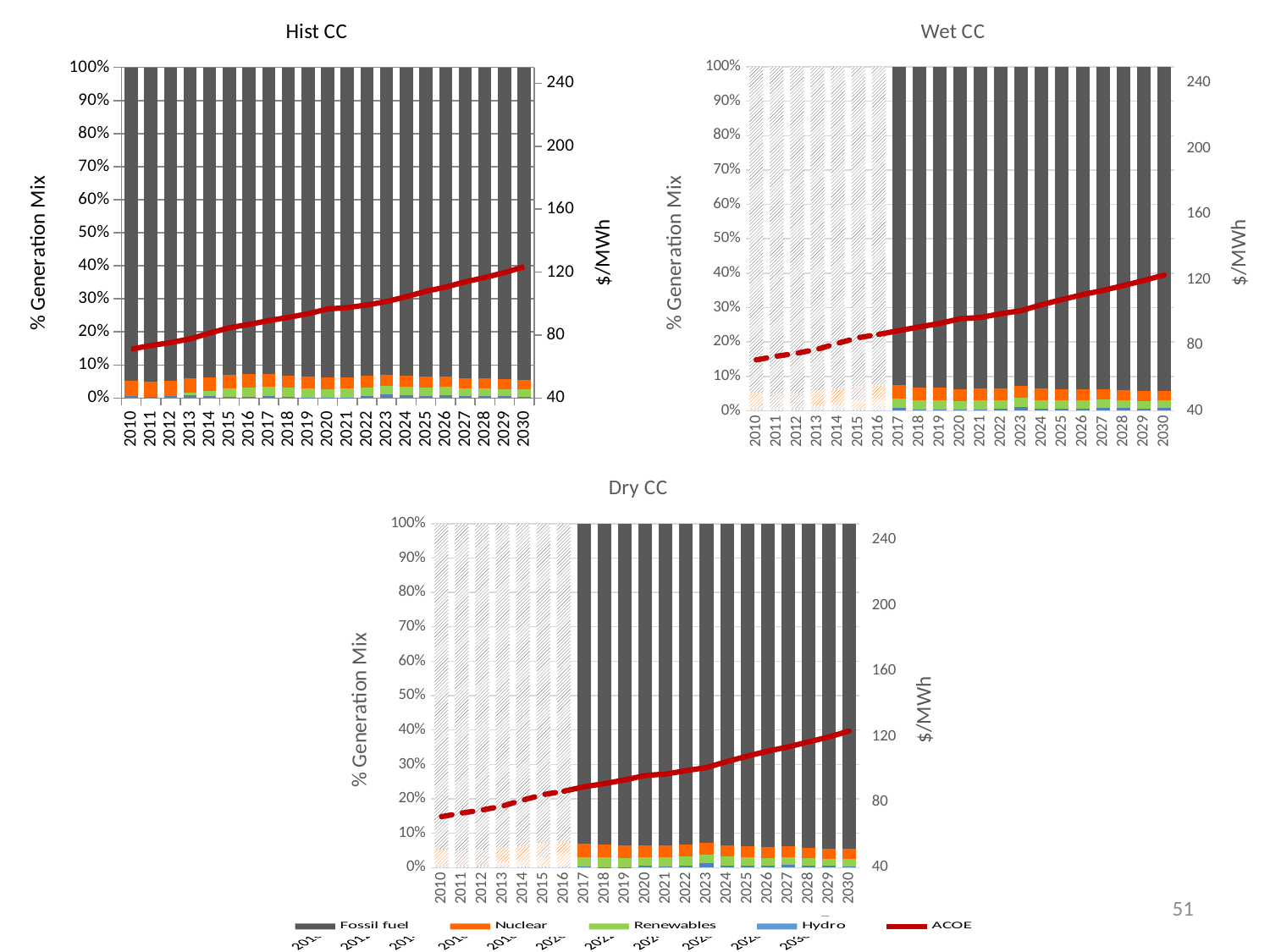
Which series is drawn as a red line in the charts? ACOE What are the titles of the three charts on the slide? Hist CC, Wet CC, Dry CC In the Wet CC chart, is the ACOE value for 2030 greater or less than 100 $/MWh? greater How many series does the legend at the bottom of the slide list? 5 In the Wet CC chart, which is larger in 2020: the Fossil fuel share or the Nuclear share? Fossil fuel How many charts are on the slide? 3 In the Hist CC chart, how many years are shown on the x axis? 21 In the Dry CC chart, is the ACOE value for 2020 greater or less than 120 $/MWh? less In the Hist CC chart, is the ACOE value for 2010 greater or less than 80 $/MWh? less In the Hist CC chart, does the ACOE line rise or fall from 2010 to 2030? Rise In the Dry CC chart, which series makes up the largest share of the generation mix in 2030? Fossil fuel In the Hist CC chart, what kind of chart is used for the generation mix? Stacked bar chart